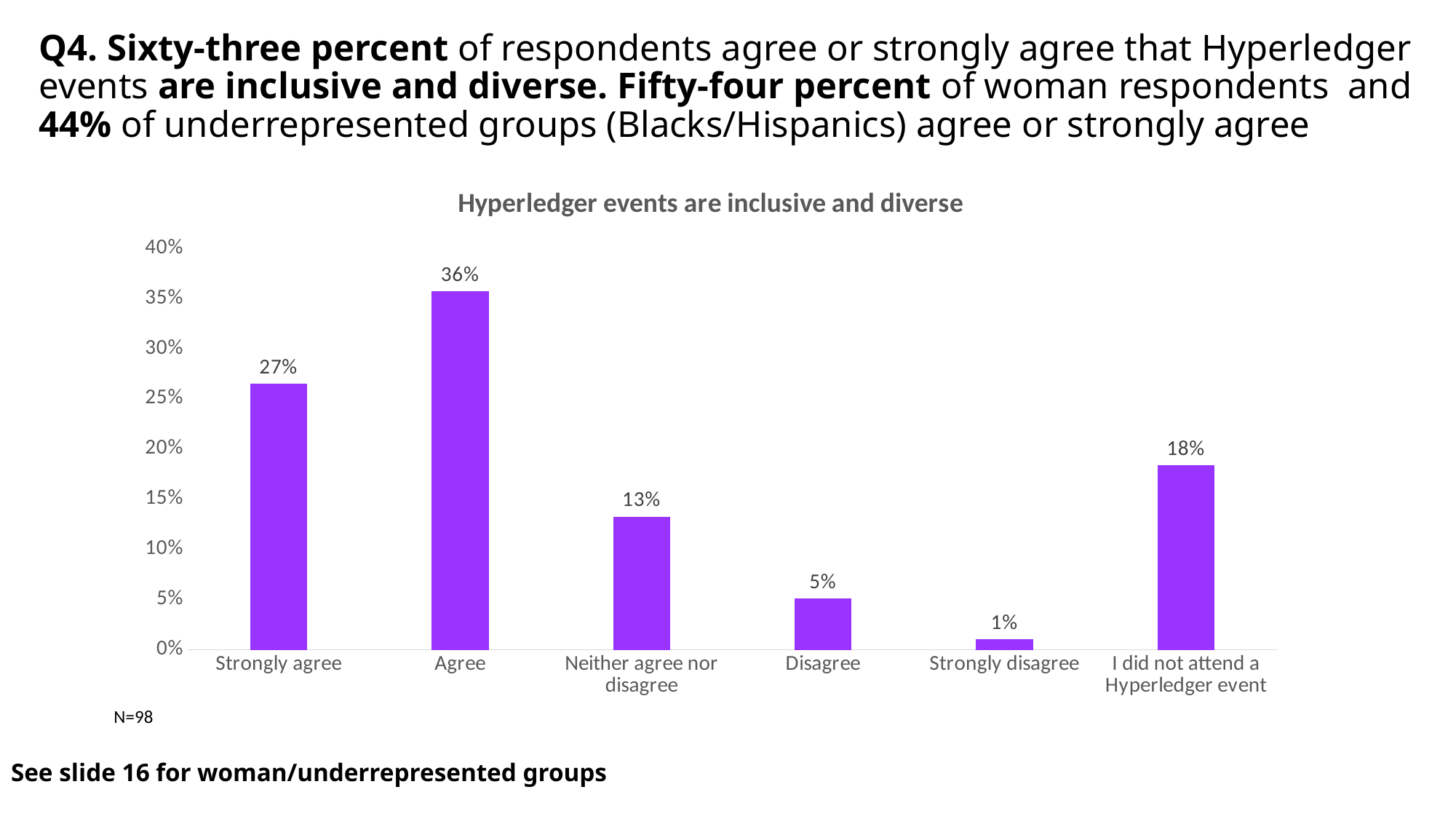
What is the value for "Strongly disagree"? 1% What is the value for "Strongly agree"? 27% What percentage of respondents chose "Agree"? 36% What is the title of the chart? Hyperledger events are inclusive and diverse What percentage of respondents said "I did not attend a Hyperledger event"? 18% What is the difference between the values for "Agree" and "Strongly agree"? 9% What kind of chart is shown on the slide? Bar chart Which is larger, the value for "Neither agree nor disagree" or the value for "I did not attend a Hyperledger event"? I did not attend a Hyperledger event Which category has the highest value? Agree Is the value for "Disagree" greater or less than 10%? less Which category has the lowest value? Strongly disagree How many categories are shown on the x axis? 6